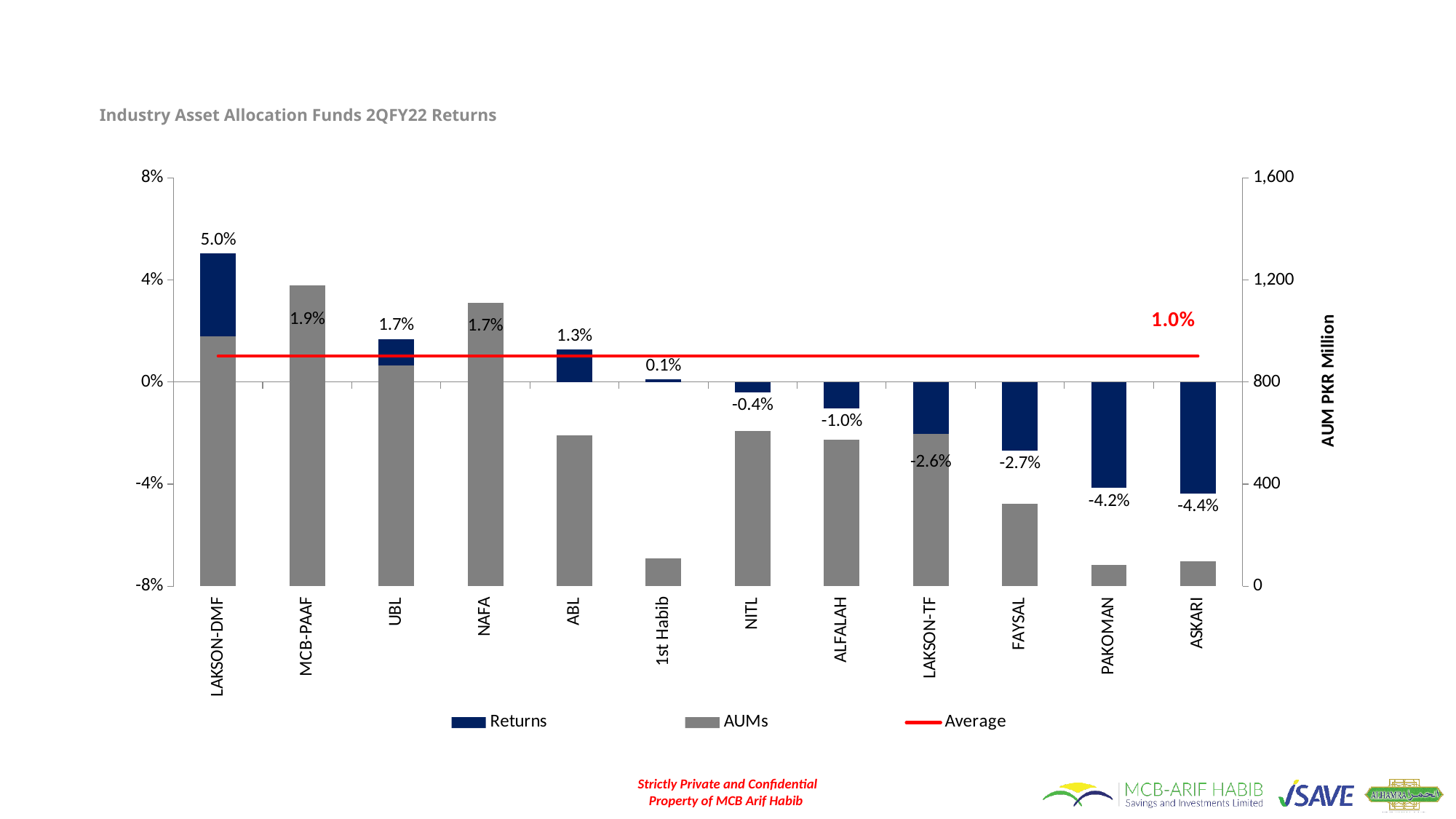
How many funds are shown on the x axis? 12 What is the average return shown by the red line? 1.0% What is the return for LAKSON-DMF? 5.0% What is the return for FAYSAL? -2.7% Which fund has the highest return? LAKSON-DMF Is the AUM for FAYSAL greater or less than 400 PKR Million? less What is the return for 1st Habib? 0.1% What is the difference in return between LAKSON-DMF and ASKARI? 9.4 percentage points Which has the higher return, ABL or NITL? ABL Which fund has the lowest return? ASKARI Which fund has the largest AUM? MCB-PAAF How many series does the legend list? 3